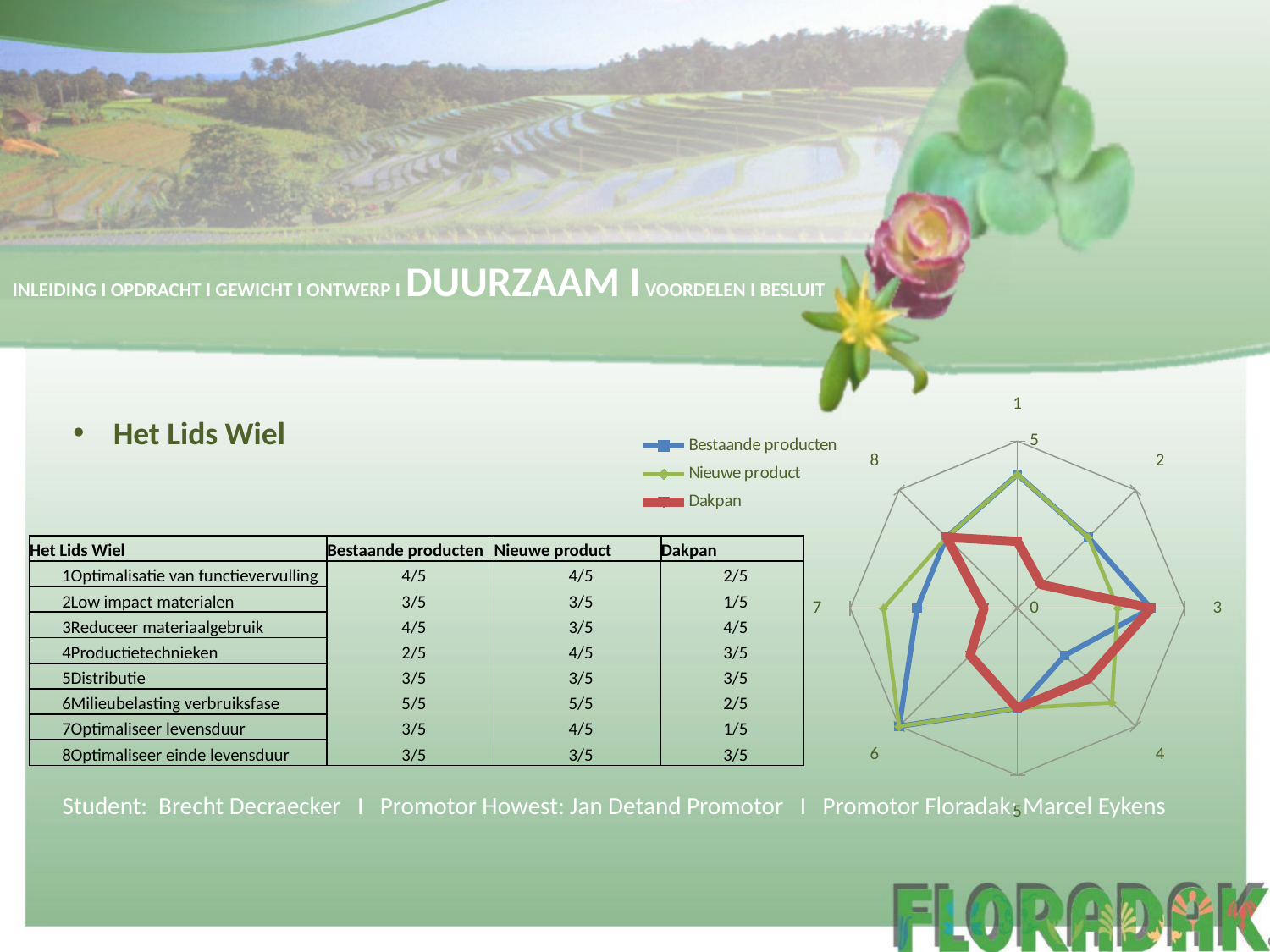
What is the value for Dakpan on category 3 (Reduceer materiaalgebruik)? 4/5 On category 6, which series has the larger value: Dakpan or Bestaande producten? Bestaande producten How many categories (axes) does the radar chart have? 8 What kind of chart is shown on the slide? Radar chart On which category does Bestaande producten have its lowest value? 4 On which category do Bestaande producten and Nieuwe product both reach their highest value? 6 Which series is drawn in red on the radar chart? Dakpan On which category does Dakpan reach its highest value? 3 On category 4, which series has the larger value: Bestaande producten or Nieuwe product? Nieuwe product What is the value for Bestaande producten on category 6 (Milieubelasting verbruiksfase)? 5/5 What is the value for Nieuwe product on category 4 (Productietechnieken)? 4/5 How many series does the chart legend list? 3